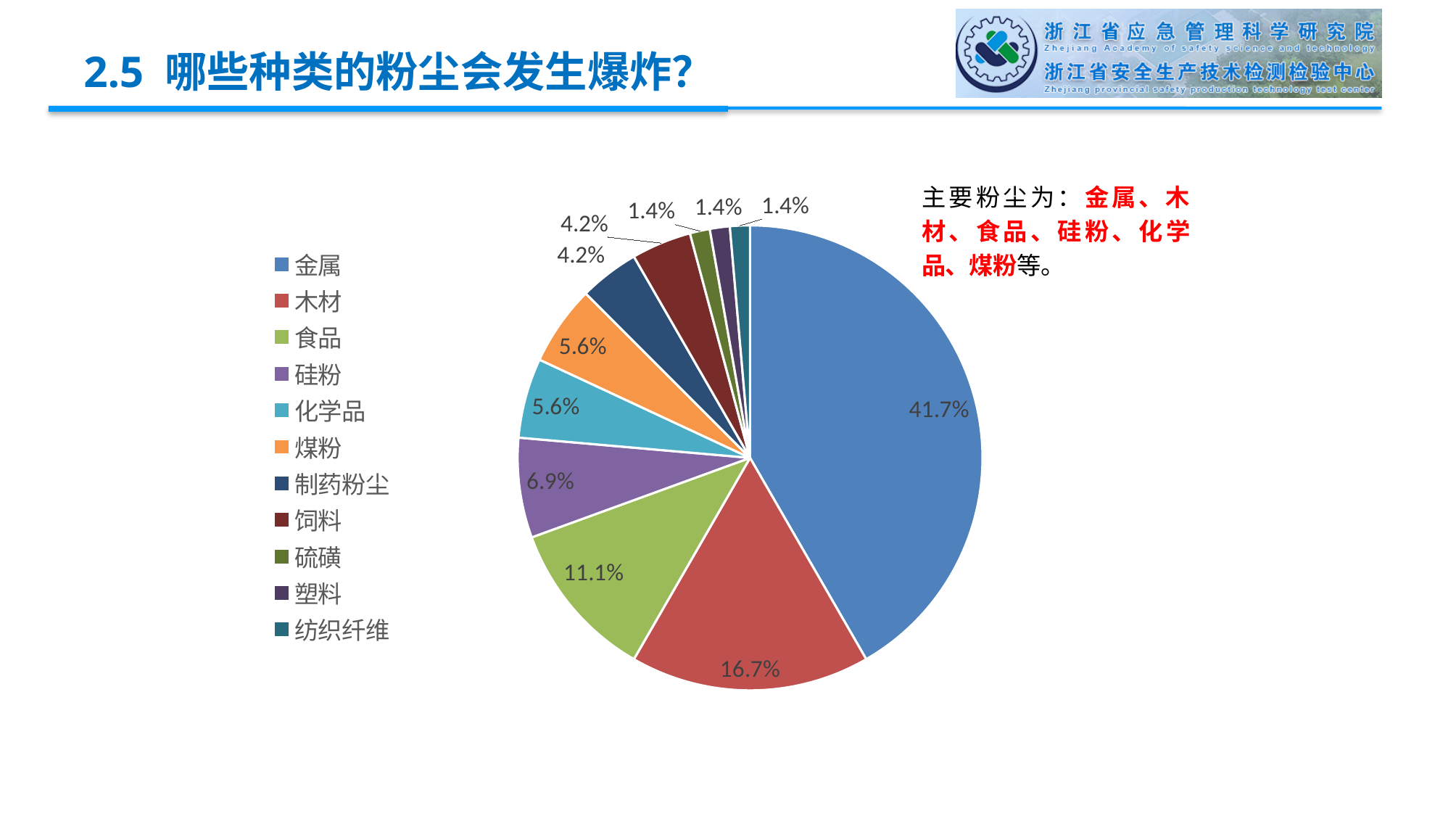
What share of the pie does 金属 have? 41.7% Which slice is larger, 食品 or 硅粉? 食品 What is the difference in percentage points between 金属 and 木材? 25.0% What share of the pie does 化学品 have? 5.6% How many categories does the legend list? 11 What is the difference in percentage points between 木材 and 食品? 5.6% What share of the pie does 木材 have? 16.7% Which category has the largest slice of the pie? 金属 What share of the pie does 硅粉 have? 6.9% What colour is the slice for 金属? blue What kind of chart is shown on the slide? pie chart What share of the pie does 食品 have? 11.1%